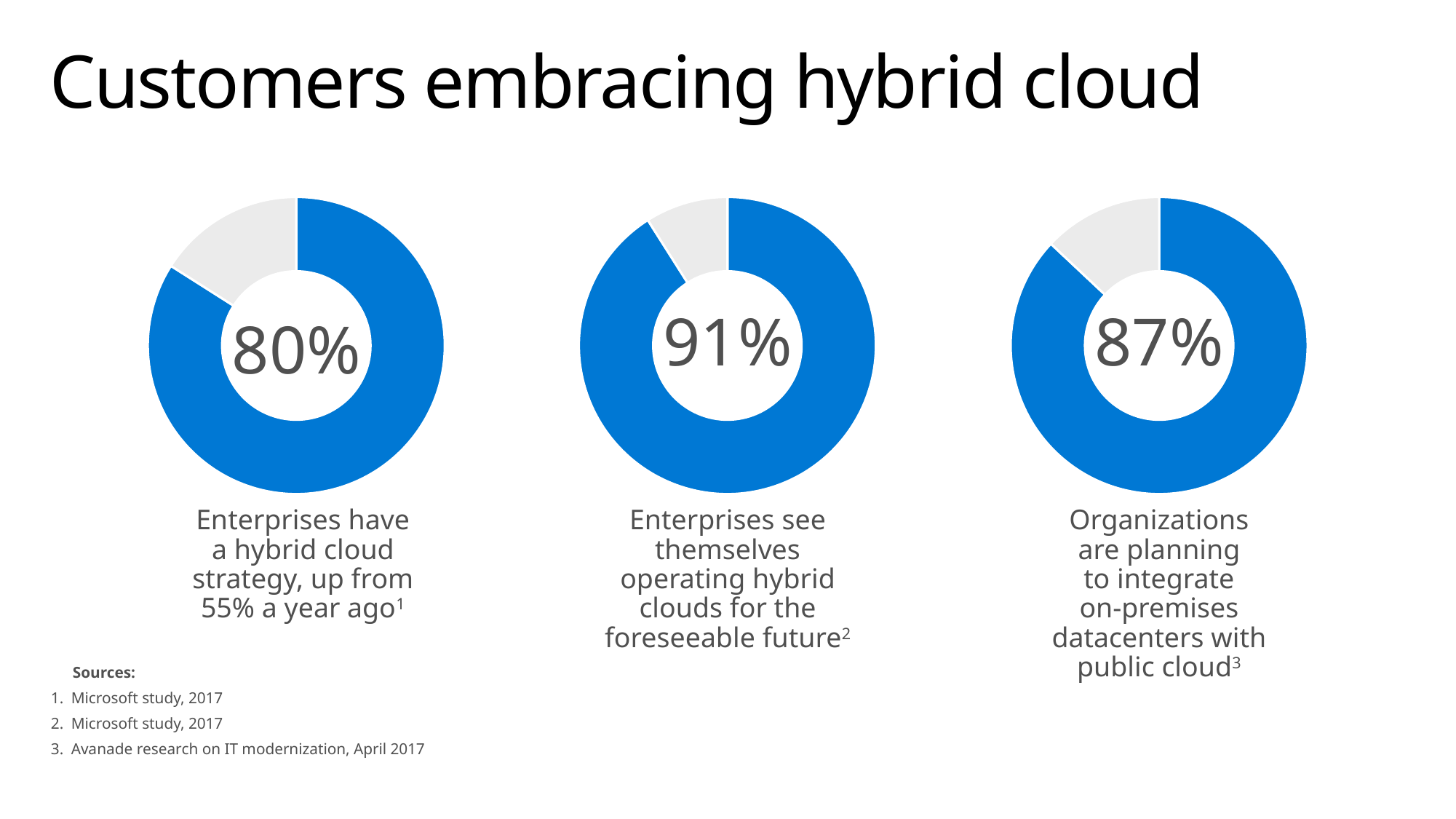
What percentage is shown in the right donut chart (organizations planning to integrate on-premises datacenters with public cloud)? 87% How many donut charts are on the slide? 3 According to the left chart's caption, what was the share of enterprises with a hybrid cloud strategy a year earlier? 55% What type of chart is used to display the percentages on this slide? Donut (pie) chart What percentage is shown in the left donut chart (enterprises with a hybrid cloud strategy)? 80% Is the percentage in the right donut chart larger or smaller than the percentage in the middle donut chart? Smaller What percentage is shown in the middle donut chart (enterprises operating hybrid clouds for the foreseeable future)? 91% Which of the three donut charts shows the lowest percentage? The left chart (80%) Which of the three donut charts shows the highest percentage? The middle chart (91%) What is the difference between the percentage in the middle donut chart and the percentage in the left donut chart? 11 percentage points What is the title of the slide? Customers embracing hybrid cloud By how many percentage points did the share of enterprises with a hybrid cloud strategy rise from a year ago, according to the left chart? 25 percentage points